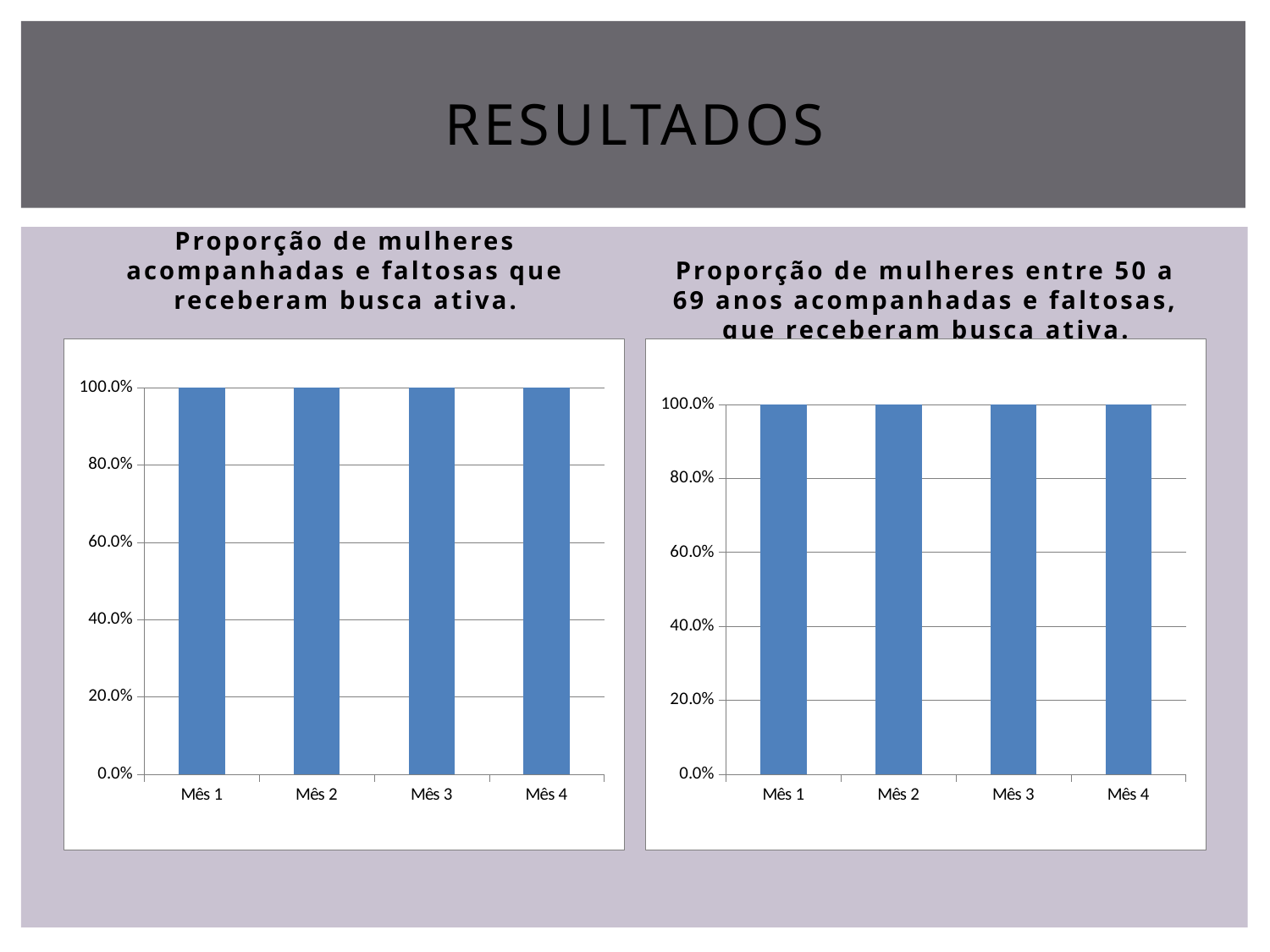
In the left chart, is the value for Mês 3 greater or less than 80.0%? greater In the right chart, 'Proporção de mulheres entre 50 a 69 anos acompanhadas e faltosas, que receberam busca ativa.', what is the value for Mês 2? 100.0% What is the label of the first category on the x axis of the right chart? Mês 1 In the right chart, what is the value for Mês 3? 100.0% In the left chart, do the values rise, fall or stay flat from Mês 1 to Mês 4? stay flat How many bars are plotted in the right chart? 4 In the right chart, do the values rise, fall or stay flat across the months? stay flat What kind of chart is the left chart, 'Proporção de mulheres acompanhadas e faltosas que receberam busca ativa.'? bar chart In the left chart, what is the value for Mês 1? 100.0% In the right chart, is the value for Mês 1 greater or less than 60.0%? greater How many categories are shown on the x axis of the left chart? 4 In the left chart, what is the value for Mês 4? 100.0%